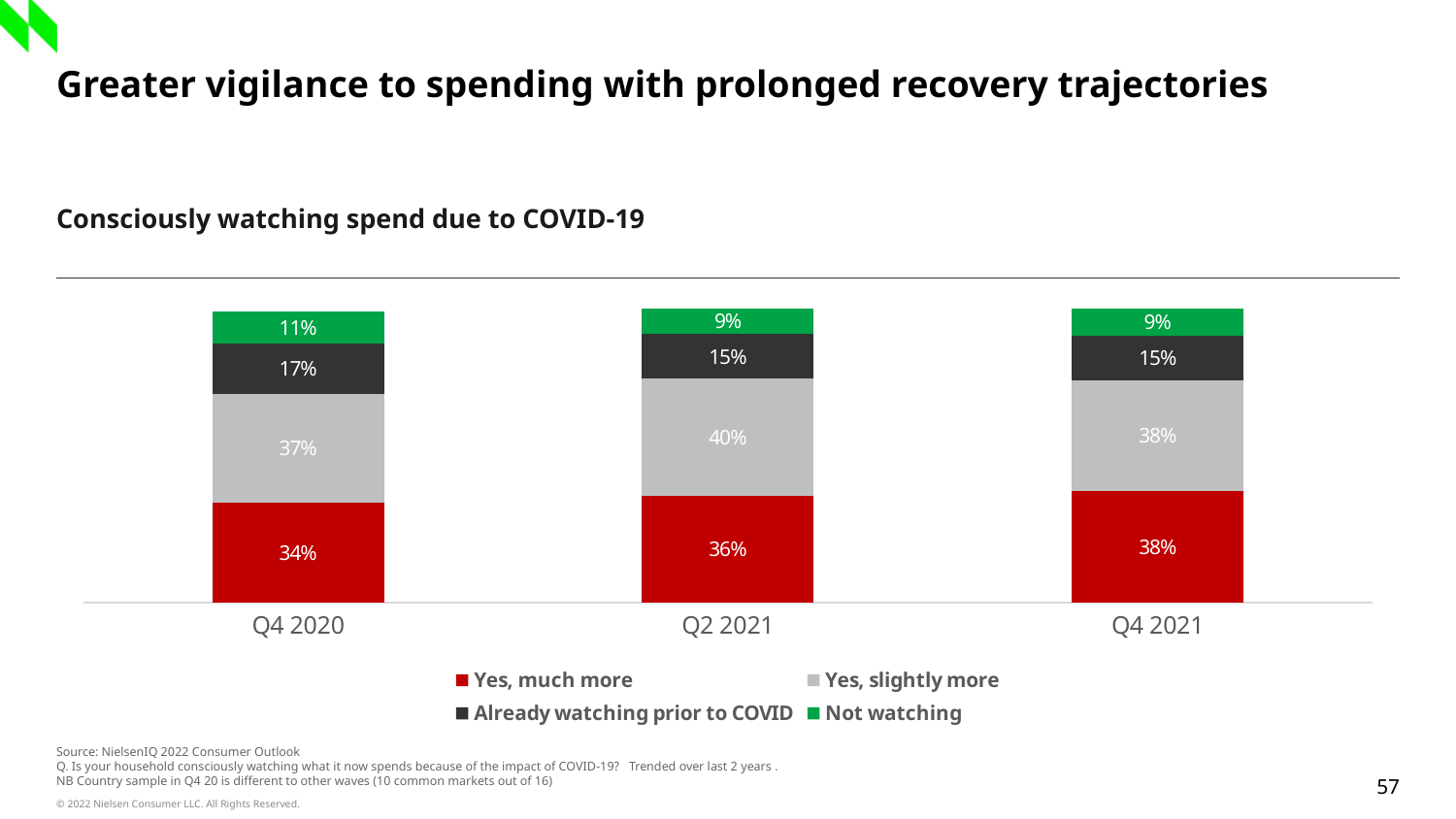
In which period is the "Yes, much more" value highest? Q4 2021 What is the difference between the "Yes, much more" values for Q4 2021 and Q4 2020? 4% In which period is the "Yes, slightly more" value lowest? Q4 2020 How many series does the chart legend list? 4 What kind of chart is shown on the slide? Stacked bar chart What is the value for "Not watching" in Q4 2020? 11% What is the value for "Already watching prior to COVID" in Q4 2020? 17% What is the value for "Yes, much more" in Q4 2021? 38% What is the title of the chart? Consciously watching spend due to COVID-19 How many time periods are shown on the x axis of the chart? 3 What is the value for "Yes, slightly more" in Q2 2021? 40% Does the "Yes, much more" value rise or fall from Q4 2020 to Q4 2021? Rise